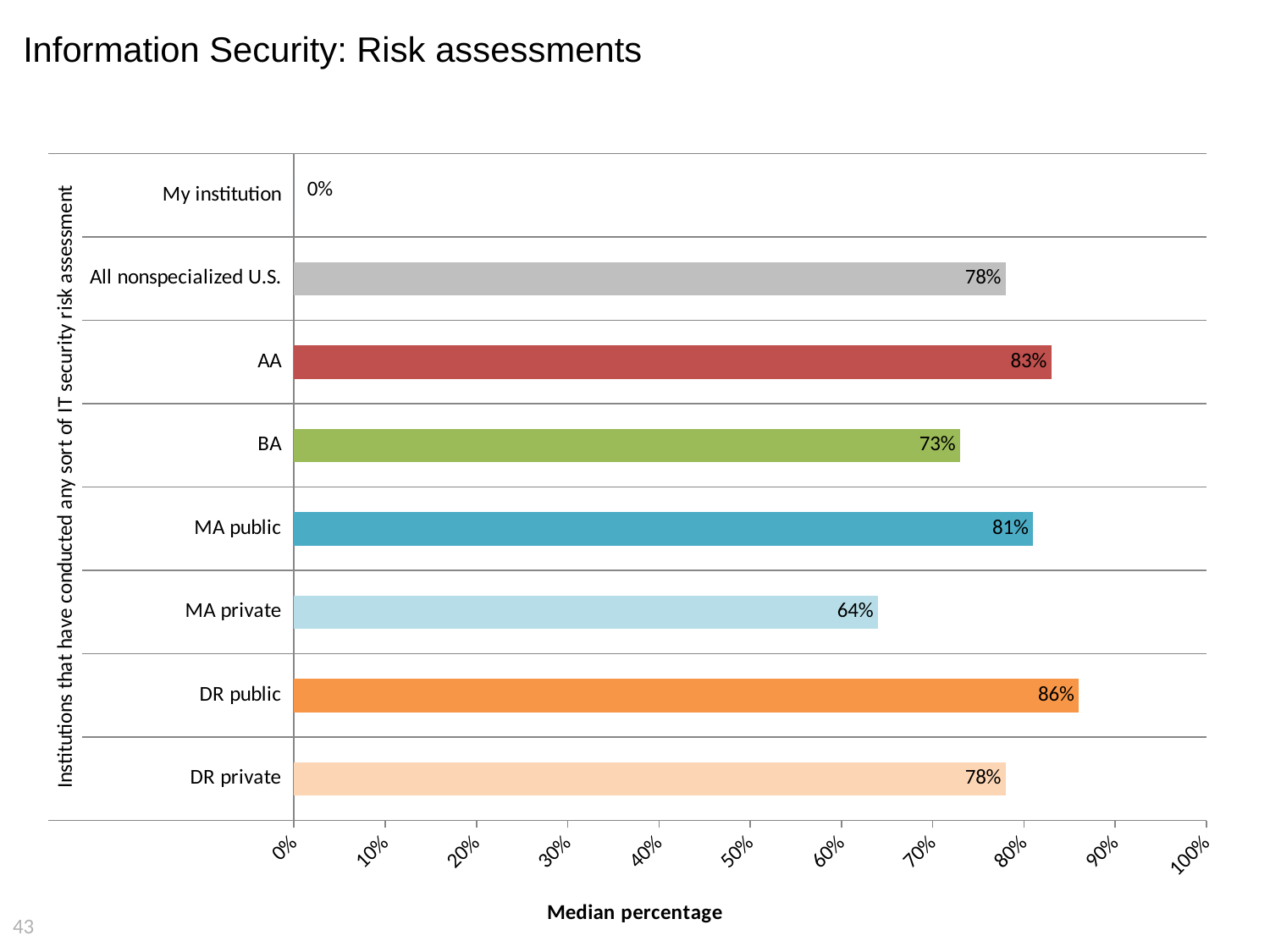
Which is larger, the value for MA public or the value for DR private? MA public Which category has the highest value? DR public What is the title of the x axis? Median percentage What kind of chart is shown on the slide? Bar chart What colour is the bar for DR public? Orange What is the value for DR public? 86% What is the value for My institution? 0% What is the value for MA private? 64% What is the value for All nonspecialized U.S.? 78% What is the difference between the values for AA and BA? 10% How many categories are shown on the chart? 8 Excluding My institution, which category has the lowest value? MA private